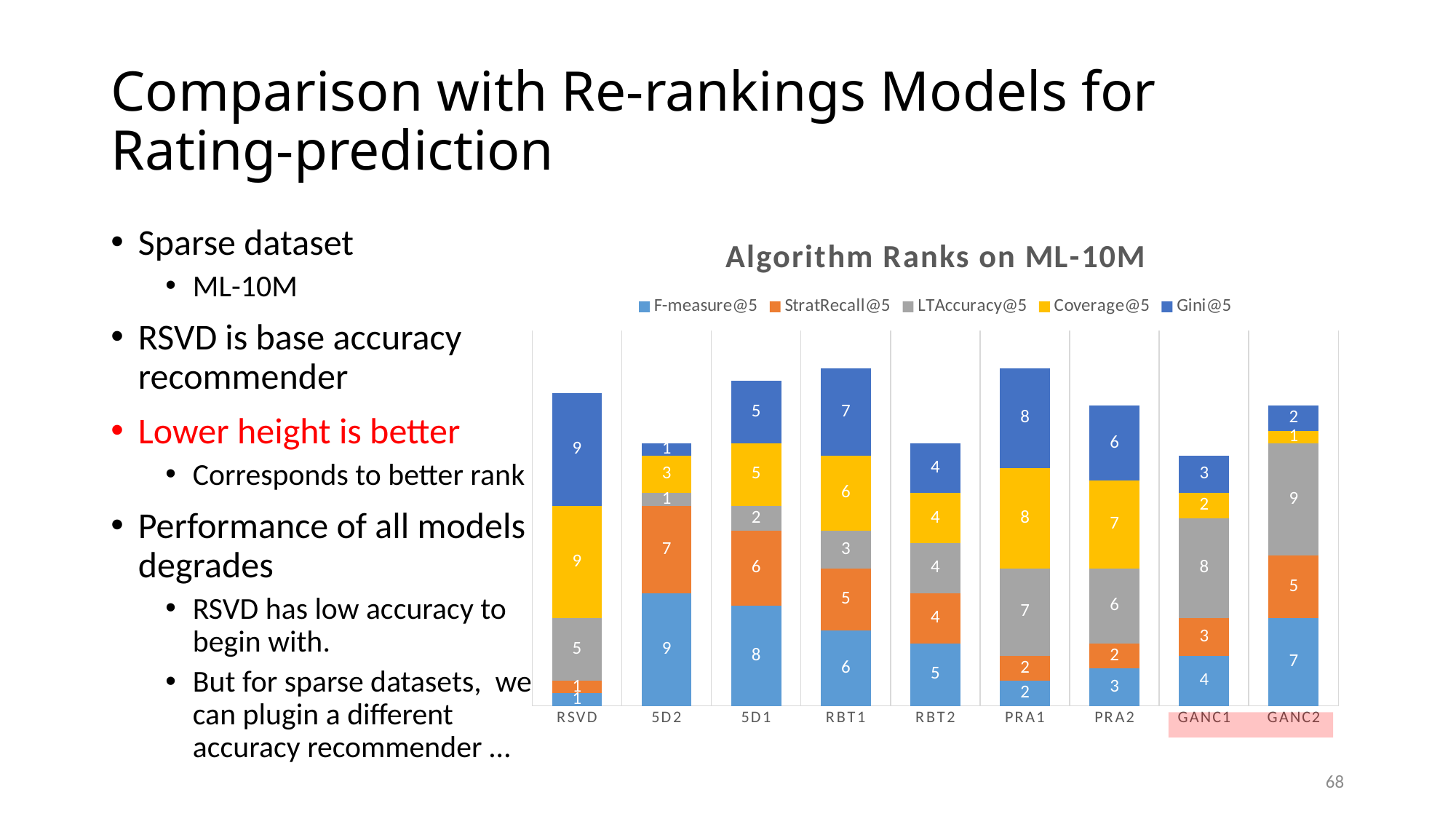
How many series does the chart legend list? 5 What type of chart is shown on the slide? Stacked bar chart What is the total stacked height (sum of ranks) for GANC1? 20 What is the difference between the F-measure@5 rank of 5D2 and that of RSVD? 8 Which algorithm has the lowest total stacked height? GANC1 What is the total stacked height (sum of ranks) for RSVD? 25 What is the F-measure@5 rank for 5D2? 9 What is the Gini@5 rank for PRA1? 8 What is the LTAccuracy@5 rank for GANC2? 9 What is the Coverage@5 rank for RSVD? 9 How many algorithms (categories) are shown on the x axis? 9 What is the title of the chart? Algorithm Ranks on ML-10M